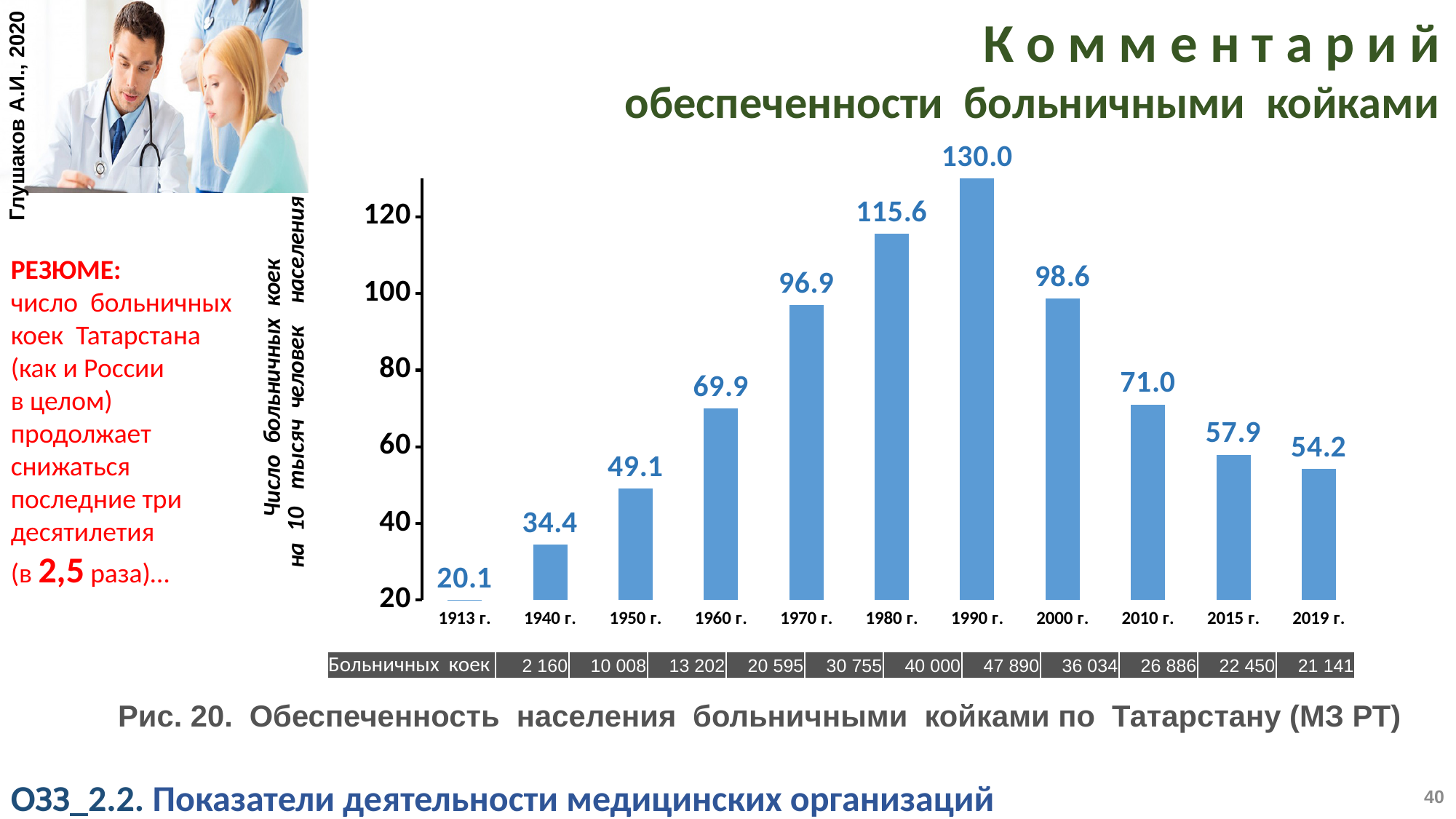
What is the value for 1913 г. in the chart? 20.1 What is the difference between the values for 2000 г. and 2010 г.? 27.6 Which year has the highest value in the chart? 1990 г. Which is larger, the value for 1970 г. or the value for 2000 г.? 2000 г. What kind of chart is shown on the slide? Bar chart Which year has the lowest value in the chart? 1913 г. How many years (categories) are shown on the x axis of the chart? 11 What is the difference between the values for 1990 г. and 2019 г.? 75.8 According to the table row 'Больничных коек' below the chart, how many hospital beds were there in 1990 г.? 47 890 What is the value for 1990 г. in the chart? 130.0 What is the value for 2019 г. in the chart? 54.2 Do the values rise or fall along the x axis from 2000 г. to 2019 г.? Fall